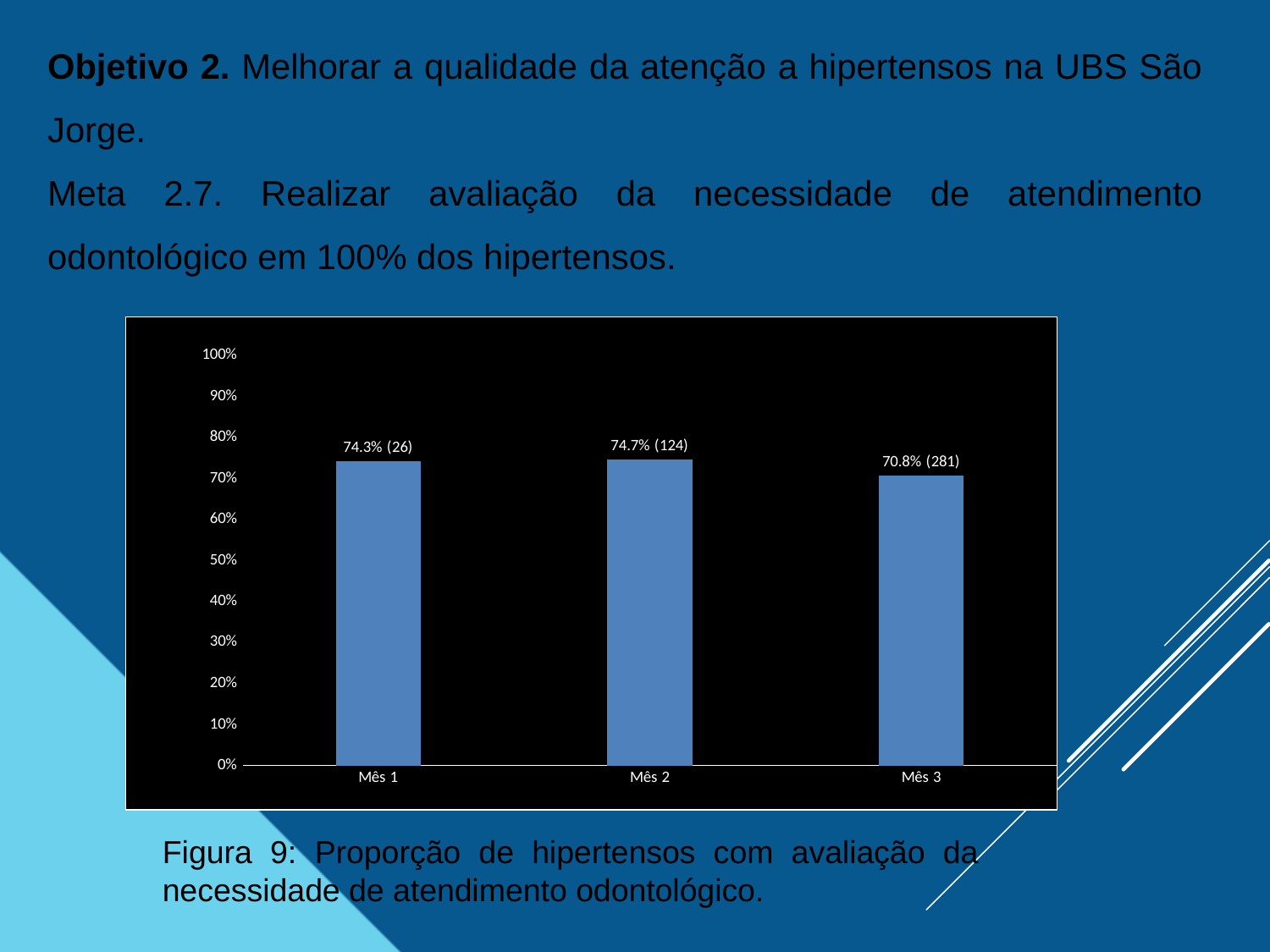
How many hypertensive patients are indicated in parentheses for Mês 3? 281 What kind of chart is shown on the slide? Bar chart Which month has the highest proportion according to the data labels? Mês 2 Is the proportion for Mês 1 larger or smaller than the proportion for Mês 3? Larger Which month has the lowest proportion? Mês 3 How many categories (months) are plotted in the chart? 3 What percentage is shown for Mês 3? 70.8% Is the value for Mês 3 greater or less than 80%? less What is the value shown for Mês 2? 74.7% (124) What is the difference in percentage points between Mês 2 and Mês 3? 3.9 percentage points According to the caption, what does Figura 9 show? Proporção de hipertensos com avaliação da necessidade de atendimento odontológico What is the value shown for Mês 1? 74.3% (26)